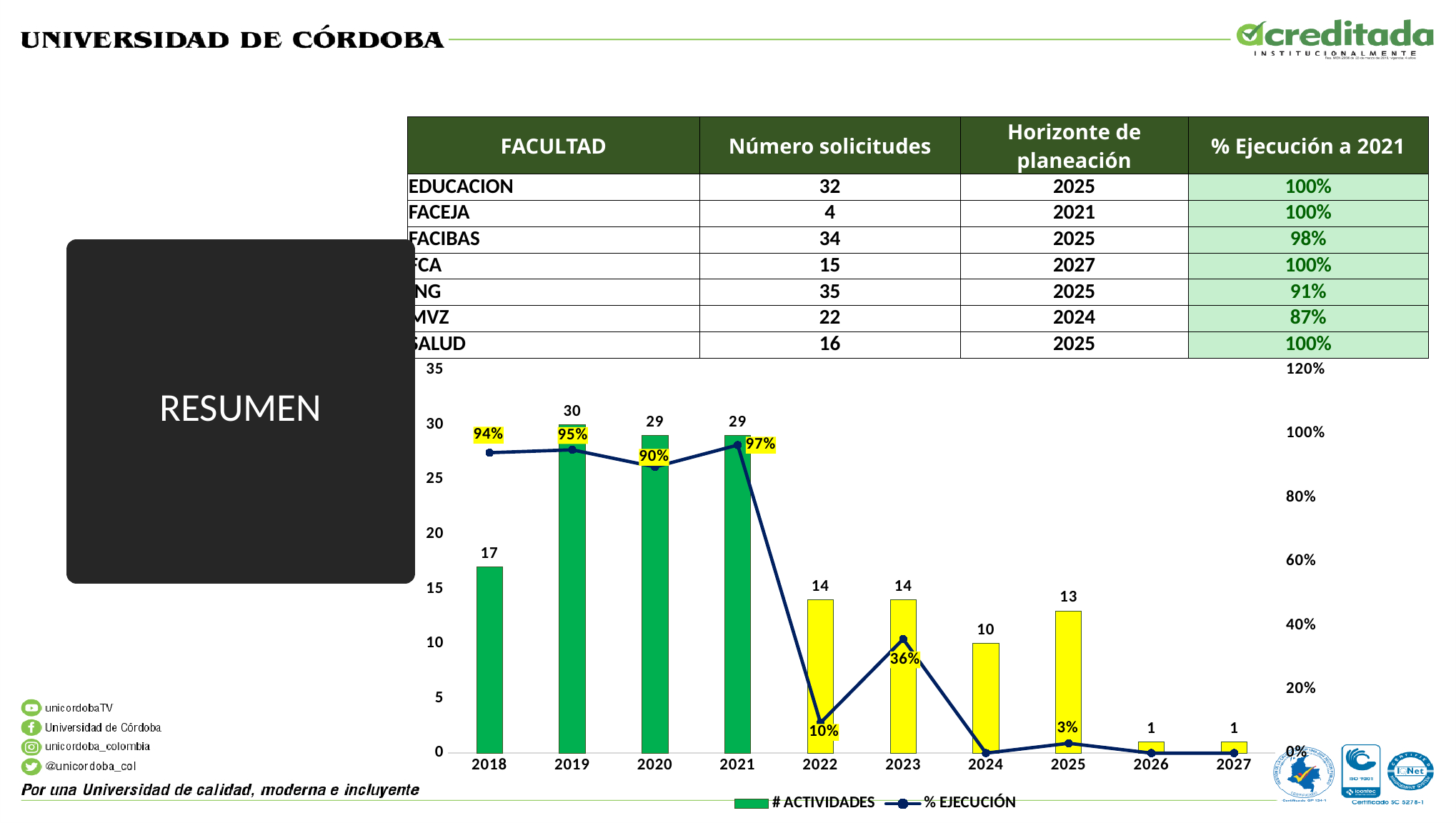
How many years are shown on the x axis of the chart? 10 What is the % EJECUCIÓN value shown for 2021? 97% Is the % EJECUCIÓN value for 2024 greater or less than 20%? less Which year has more activities, 2024 or 2025? 2025 How many series does the chart legend list? 2 Which year has the highest number of activities? 2019 What kind of chart is used to show # ACTIVIDADES? Bar chart What is the % EJECUCIÓN value shown for 2022? 10% What is the number of activities (# ACTIVIDADES) shown for 2019? 30 Does the % EJECUCIÓN line rise or fall from 2021 to 2022? Fall What is the difference in number of activities between 2019 and 2018? 13